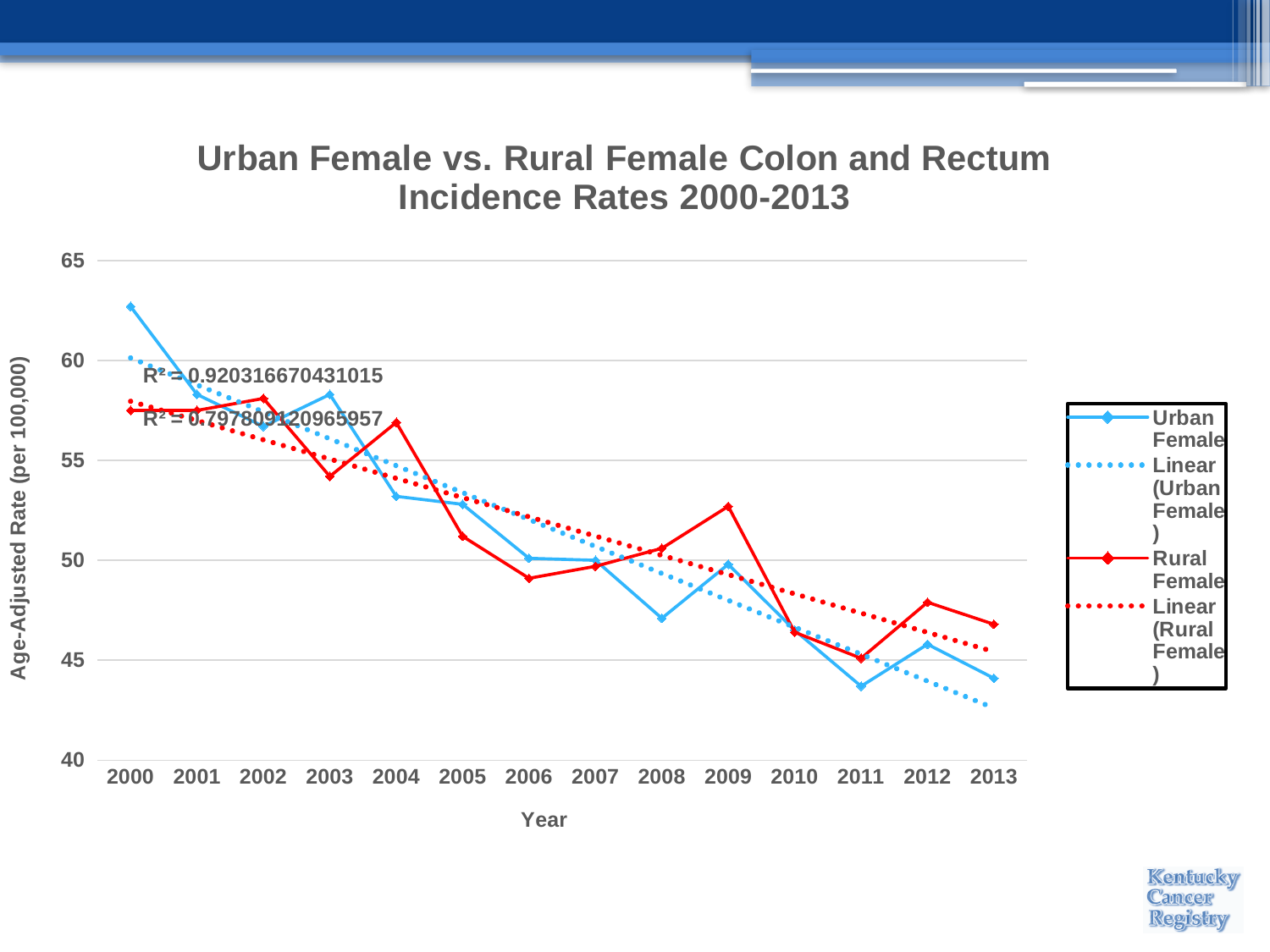
How many entries does the legend list? 4 Is the Urban Female value for 2011 greater or less than 45? less Do the Urban Female incidence rates generally rise or fall from 2000 to 2013? fall How many years are plotted along the x axis? 14 In 2009, which series has the higher value, Urban Female or Rural Female? Rural Female Is the Rural Female value for 2009 greater or less than 50? greater What kind of chart is shown on the slide? line chart Is the Urban Female value for 2000 greater or less than 60? greater In 2000, which series has the higher value, Urban Female or Rural Female? Urban Female In which year is the Urban Female rate highest? 2000 What R² value is shown for the Urban Female linear trendline? 0.920316670431015